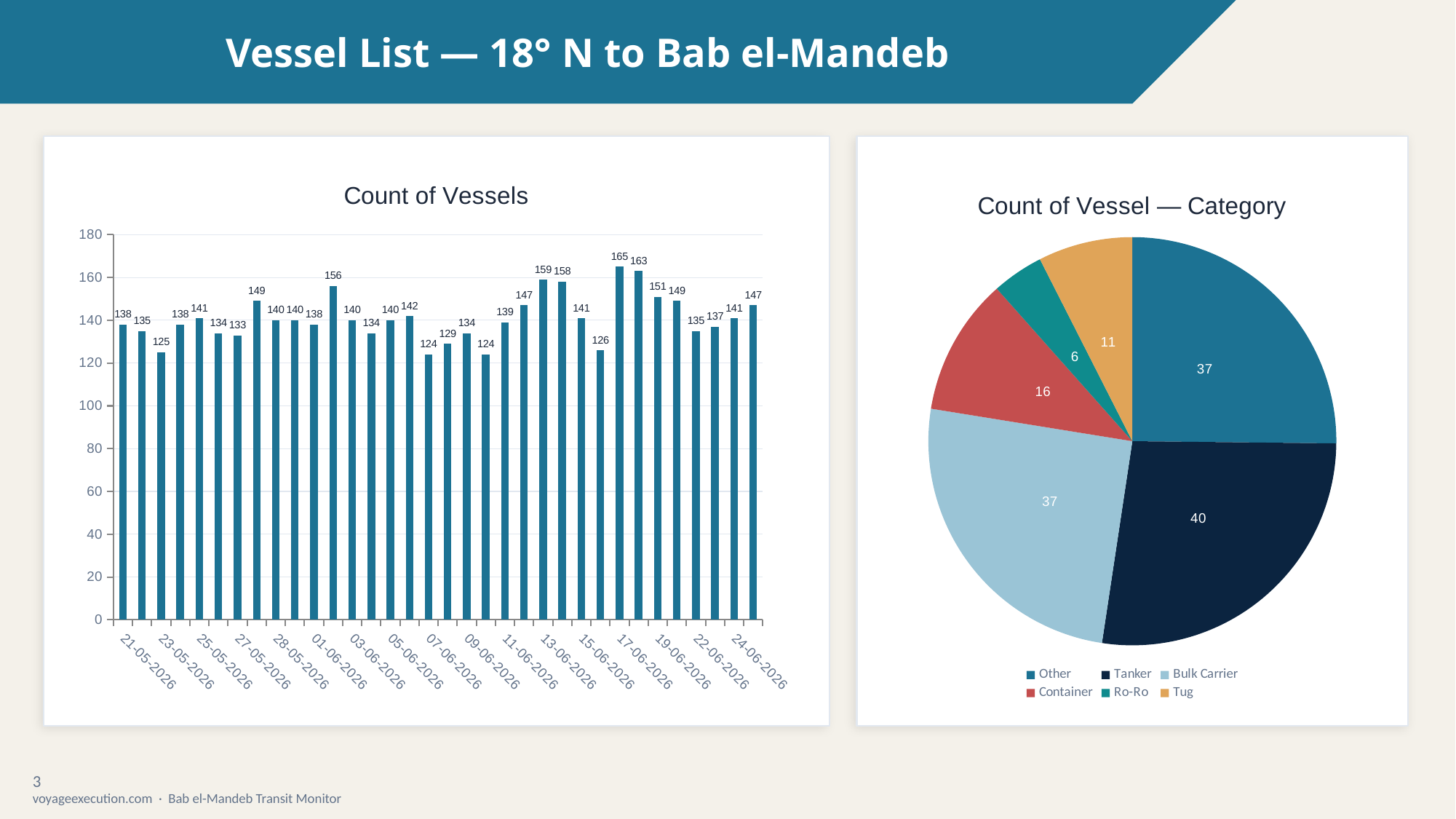
In the pie chart 'Count of Vessel — Category', what is the difference between the Container and Tug values? 5 In the bar chart 'Count of Vessels', what is the highest value shown? 165 What kind of chart is 'Count of Vessels' on the left of the slide? Bar chart What kind of chart is 'Count of Vessel — Category'? Pie chart In the pie chart 'Count of Vessel — Category', what is the value for Tanker? 40 In the pie chart 'Count of Vessel — Category', which category has the smallest slice? Ro-Ro In the bar chart 'Count of Vessels', what is the lowest value shown? 124 In the pie chart 'Count of Vessel — Category', which is larger, Container or Bulk Carrier? Bulk Carrier How many categories does the legend of the pie chart 'Count of Vessel — Category' list? 6 In the pie chart 'Count of Vessel — Category', what is the value for Ro-Ro? 6 In the pie chart 'Count of Vessel — Category', which category has the largest slice? Tanker What is the total of all slices in the pie chart 'Count of Vessel — Category'? 147